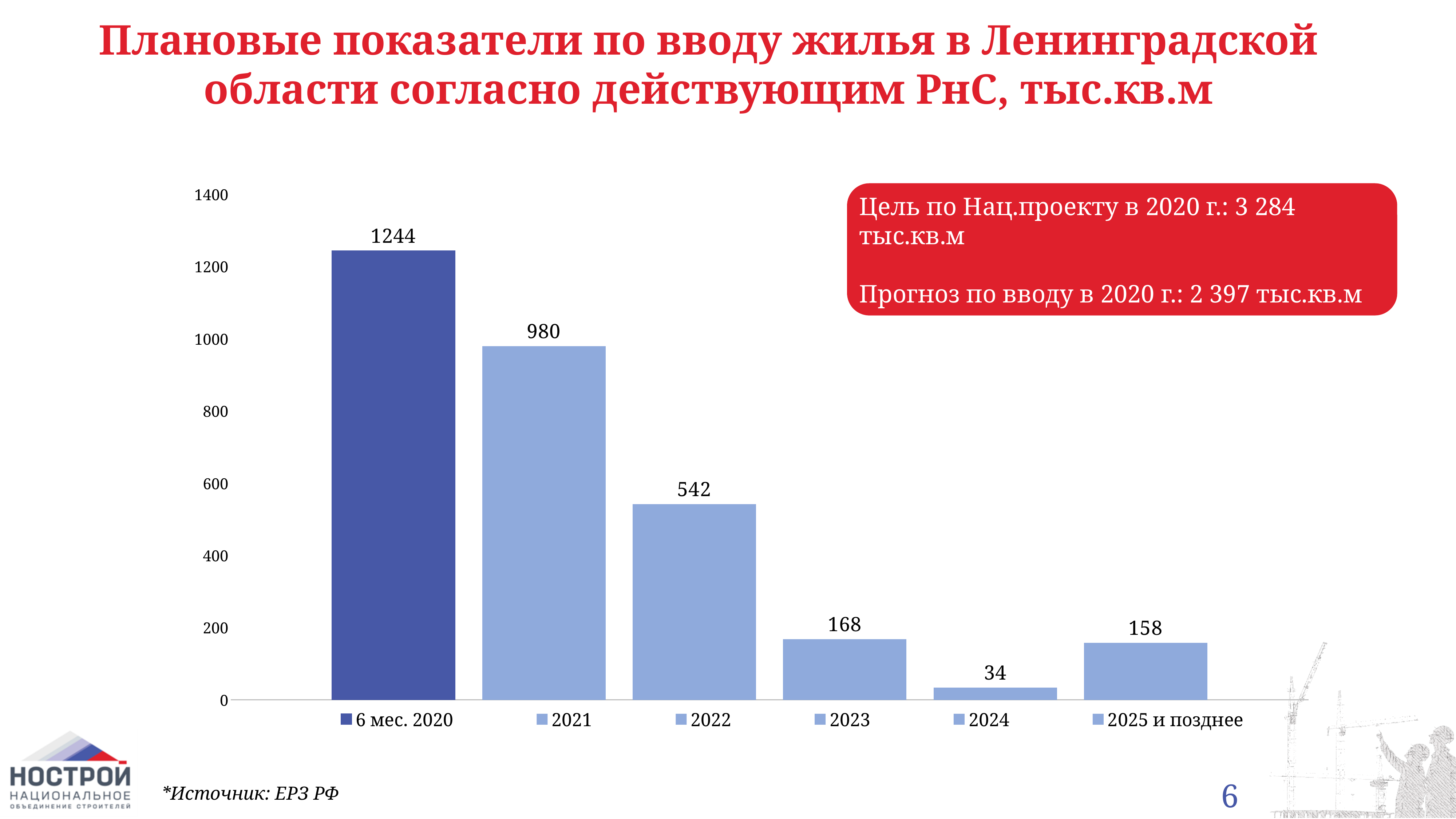
What is the value for 2021? 980 Which is larger, the value for 2023 or the value for 2025 и позднее? 2023 What is the difference between the values for 6 мес. 2020 and 2021? 264 What is the difference between the values for 2022 and 2023? 374 Which category has the highest value? 6 мес. 2020 Do the values generally rise or fall from 6 мес. 2020 to 2024? fall What is the value for 2025 и позднее? 158 What is the value for 2023? 168 What kind of chart is shown on the slide? bar chart Which category has the lowest value? 2024 Is the value for 2022 greater or less than 600? less How many categories are shown in the chart? 6